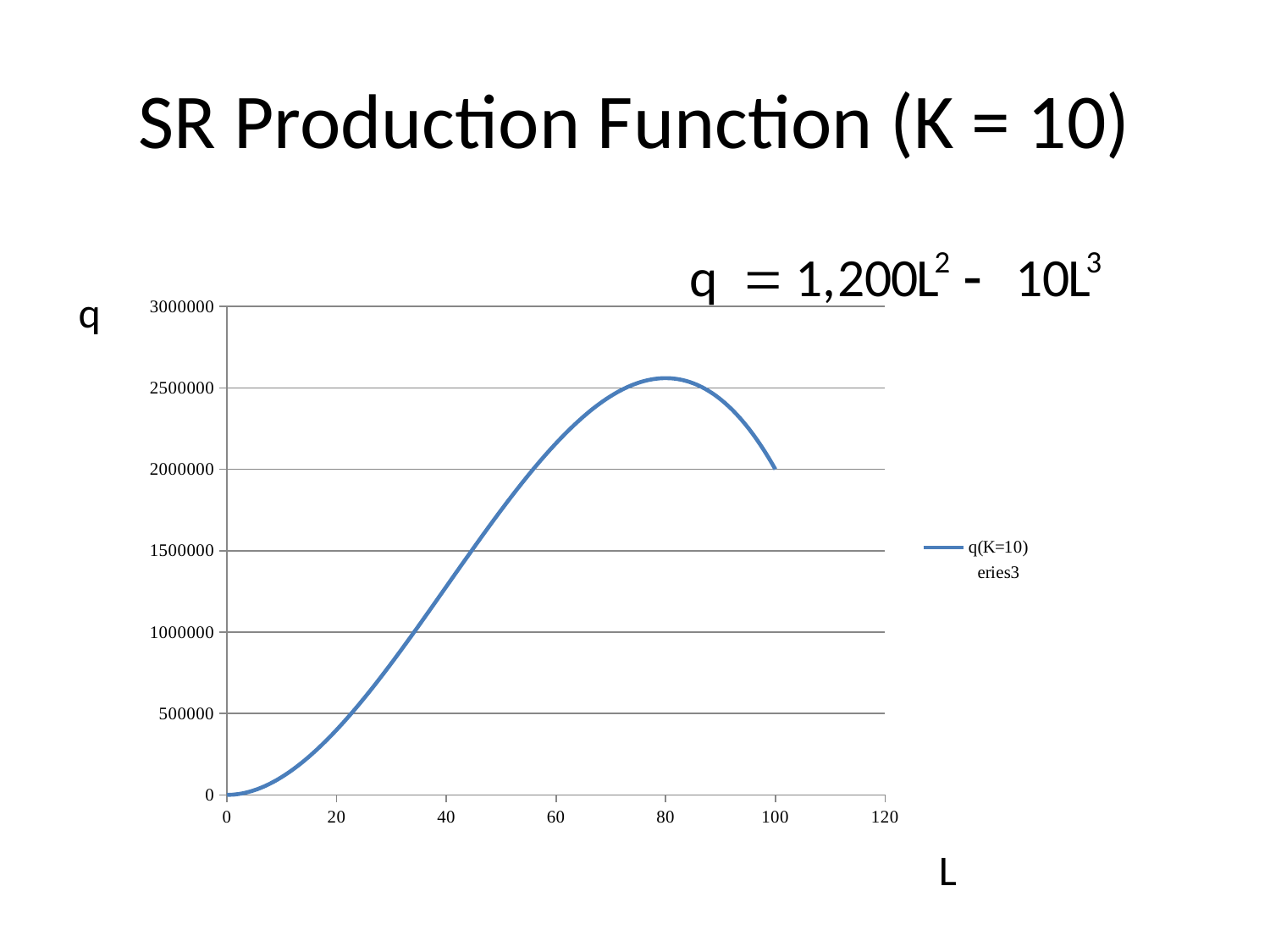
Does the curve rise or fall as L increases from 0 to 60? rise Is the value of q at L = 20 greater or less than 500000? less What kind of chart is shown on the slide? line chart Is the value of q at L = 40 greater or less than 1000000? greater What is the value of q at L = 0 on the chart? 0 What is the value of q at L = 100 on the chart? 2000000 What is the name of the first legend entry on the chart? q(K=10) Which is larger, the value of q at L = 80 or at L = 100? L = 80 Is the value of q at L = 80 greater or less than 2500000? greater Does the curve rise or fall as L increases from 80 to 100? fall What is the title of the chart on the slide? SR Production Function (K = 10)